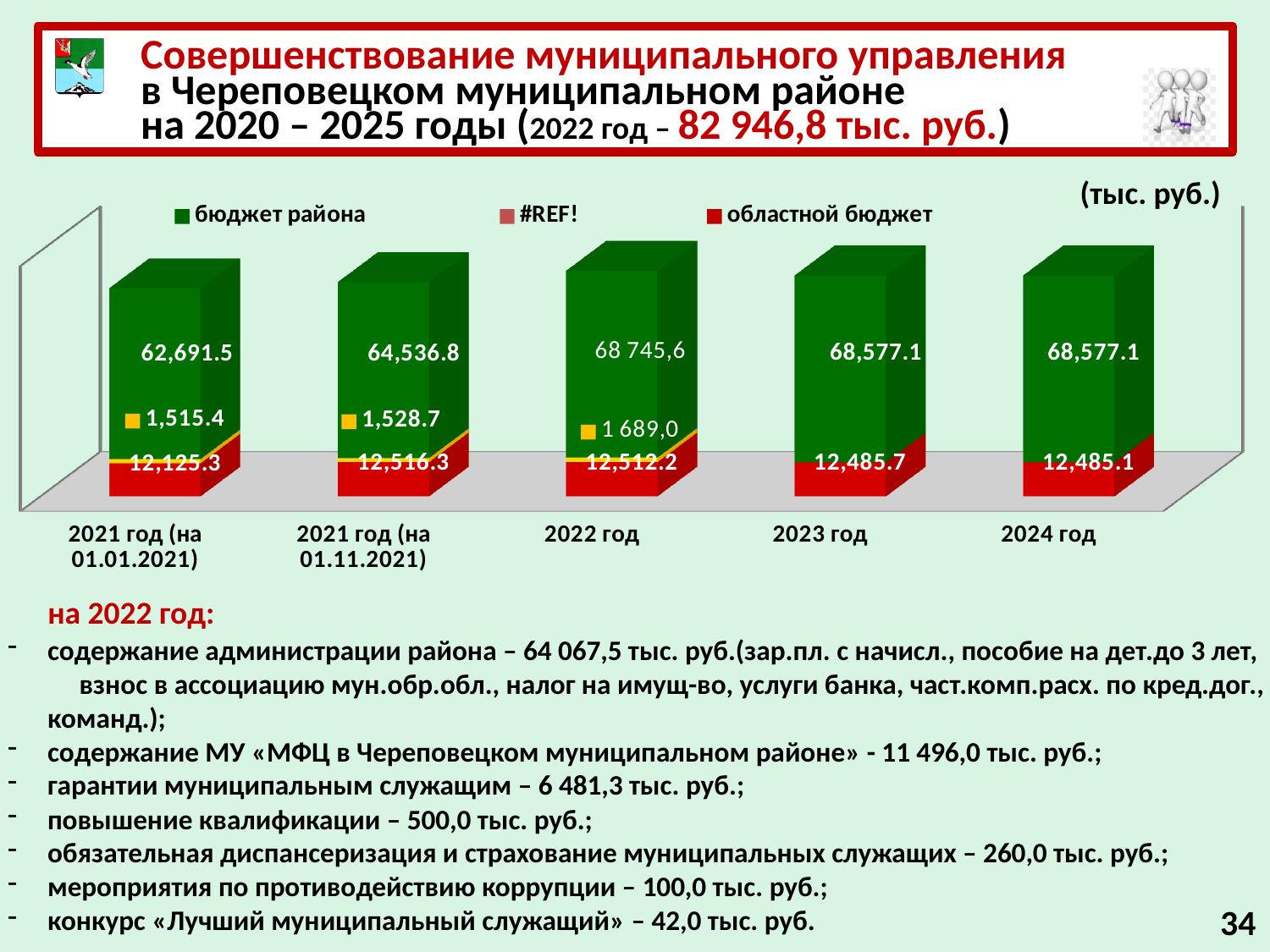
How many categories (years) are shown on the x axis of the chart? 5 What type of chart is shown on the slide? bar chart What is the difference between "областной бюджет" for "2021 год (на 01.11.2021)" and for "2021 год (на 01.01.2021)"? 391.0 Which category has the lowest value for "бюджет района"? 2021 год (на 01.01.2021) What is the value of "областной бюджет" for "2021 год (на 01.01.2021)"? 12,125.3 What is the value of "бюджет района" for "2022 год"? 68 745,6 How many series does the chart legend list? 3 What is the value of "областной бюджет" for "2024 год"? 12,485.1 What is the total of the stacked bar for "2022 год"? 82 946,8 Which is larger: "бюджет района" for "2021 год (на 01.01.2021)" or for "2021 год (на 01.11.2021)"? 2021 год (на 01.11.2021)